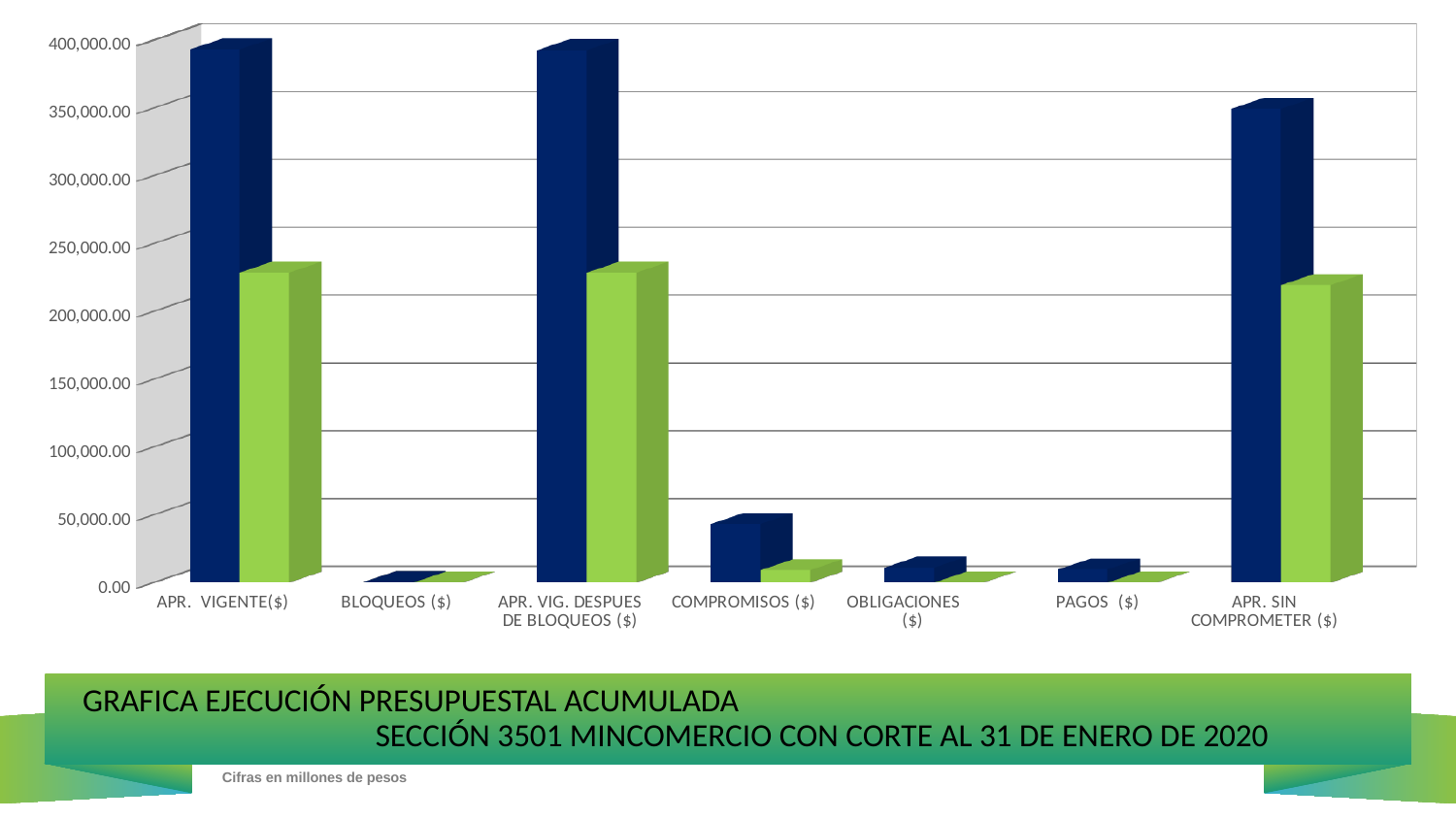
How many categories are shown on the x axis of the chart? 7 Which is larger, the dark blue bar for APR. VIGENTE($) or the dark blue bar for COMPROMISOS ($)? APR. VIGENTE($) Is the green bar for APR. VIGENTE($) greater or less than 200,000.00? greater Is the dark blue bar for OBLIGACIONES ($) greater or less than 50,000.00? less Is the dark blue bar for APR. VIGENTE($) greater or less than 350,000.00? greater Which is larger, the green bar for APR. VIG. DESPUES DE BLOQUEOS ($) or the green bar for PAGOS ($)? APR. VIG. DESPUES DE BLOQUEOS ($) For APR. VIGENTE($), which bar is taller, the dark blue one or the green one? The dark blue one What kind of chart is shown on the slide? Bar chart According to the note below the chart, in what units are the figures expressed? Millones de pesos